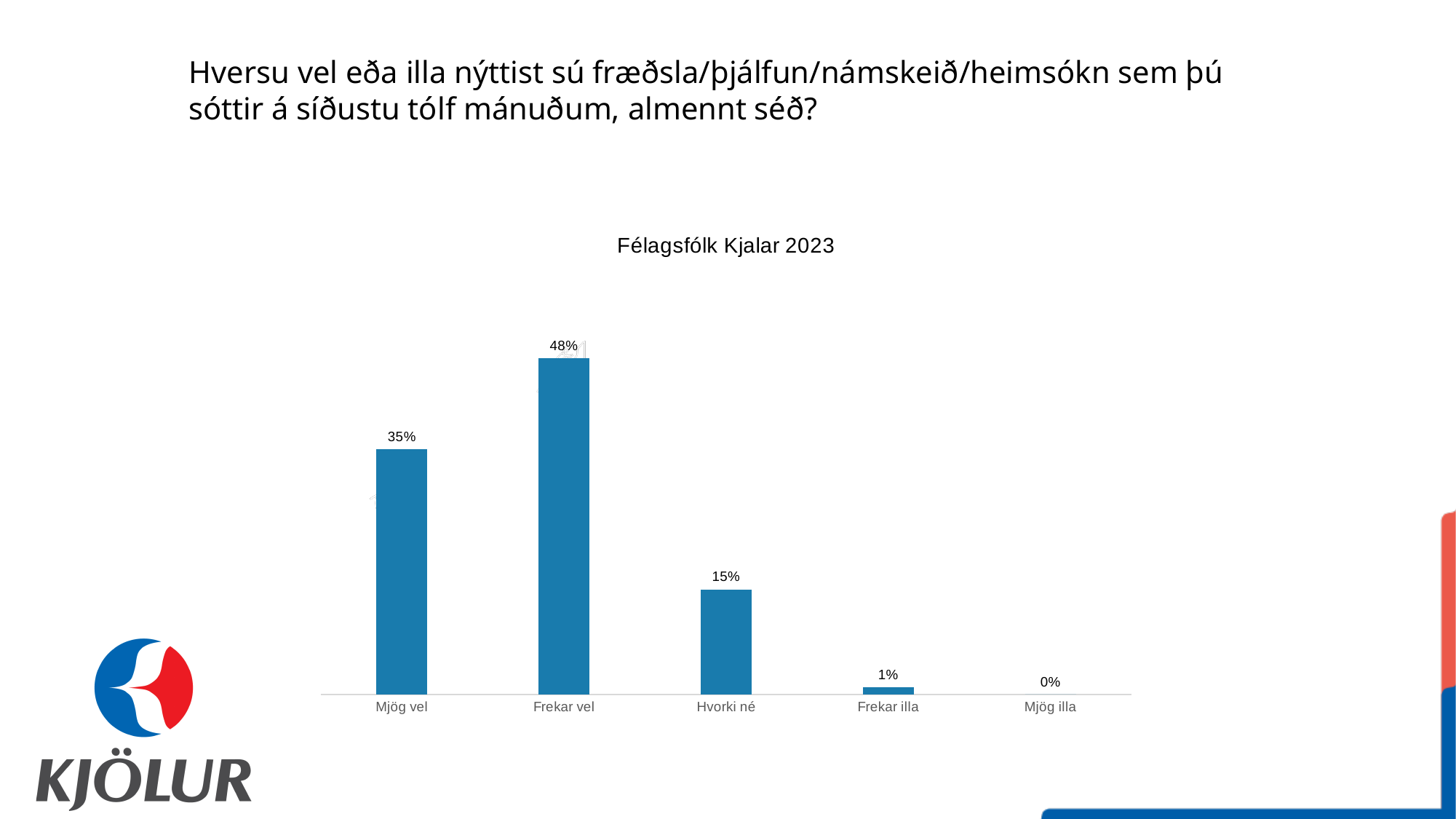
Which is larger, the value for Mjög vel or the value for Hvorki né? Mjög vel What is the value for Mjög illa? 0% Which category has the lowest value? Mjög illa What is the difference between the values for Frekar vel and Mjög vel? 13% What kind of chart is shown on the slide? Bar chart What is the value for Hvorki né? 15% What is the value for Frekar vel? 48% How many categories are shown on the x axis? 5 What is the value for Mjög vel? 35% What is the title of the chart? Félagsfólk Kjalar 2023 What is the value for Frekar illa? 1% Which category has the highest value? Frekar vel